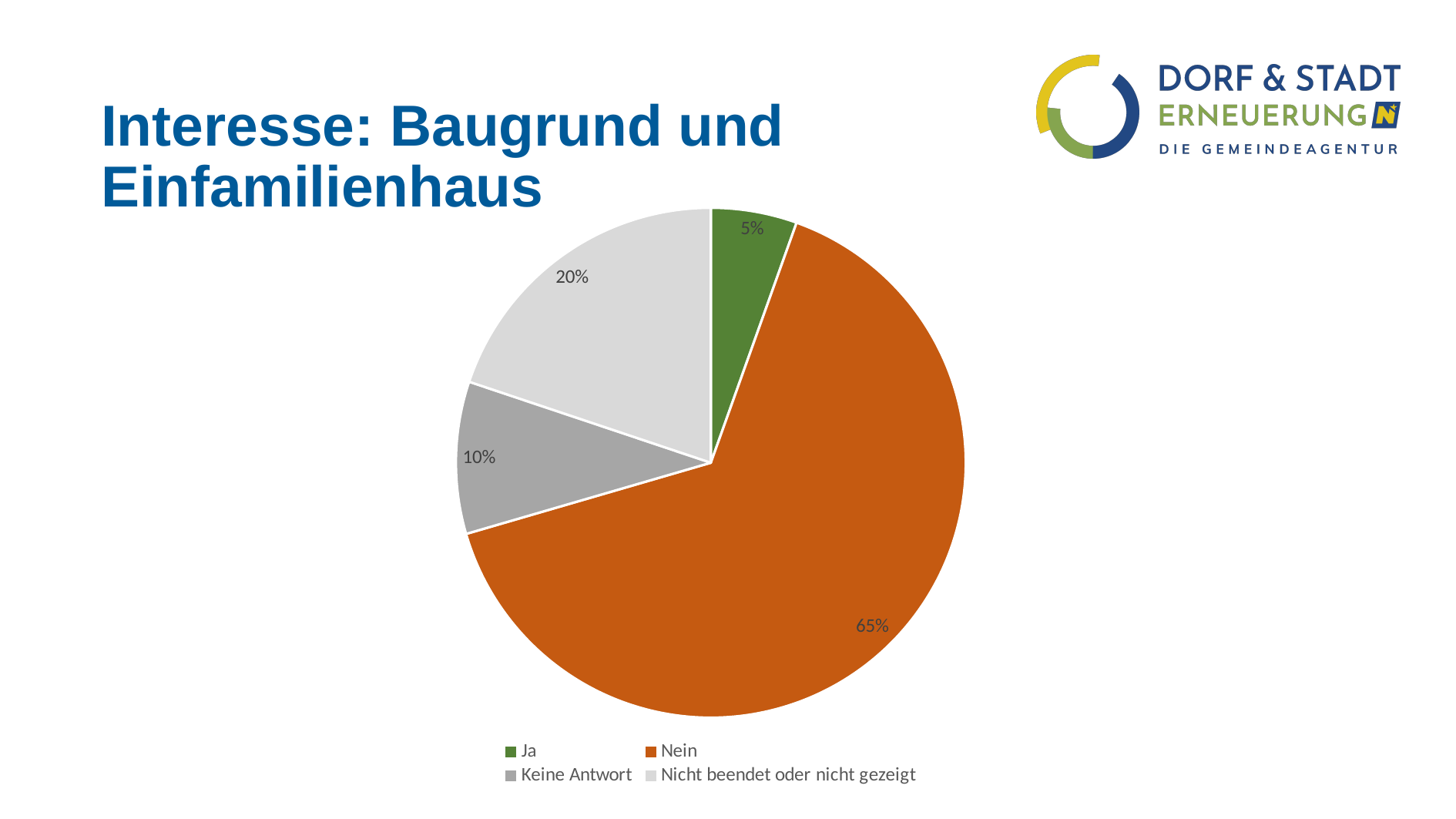
How many slices does the pie chart have? 4 Which category has the smallest slice of the pie? Ja What share of the pie does "Nicht beendet oder nicht gezeigt" have? 20% What kind of chart is shown on the slide? pie chart What share of the pie does "Ja" have? 5% What share of the pie does "Keine Antwort" have? 10% What colour is the "Nein" slice? orange Which category has the largest slice of the pie? Nein Which is larger, the share for "Keine Antwort" or the share for "Ja"? Keine Antwort What is the difference in percentage points between "Nein" and "Nicht beendet oder nicht gezeigt"? 45 How many entries does the legend list? 4